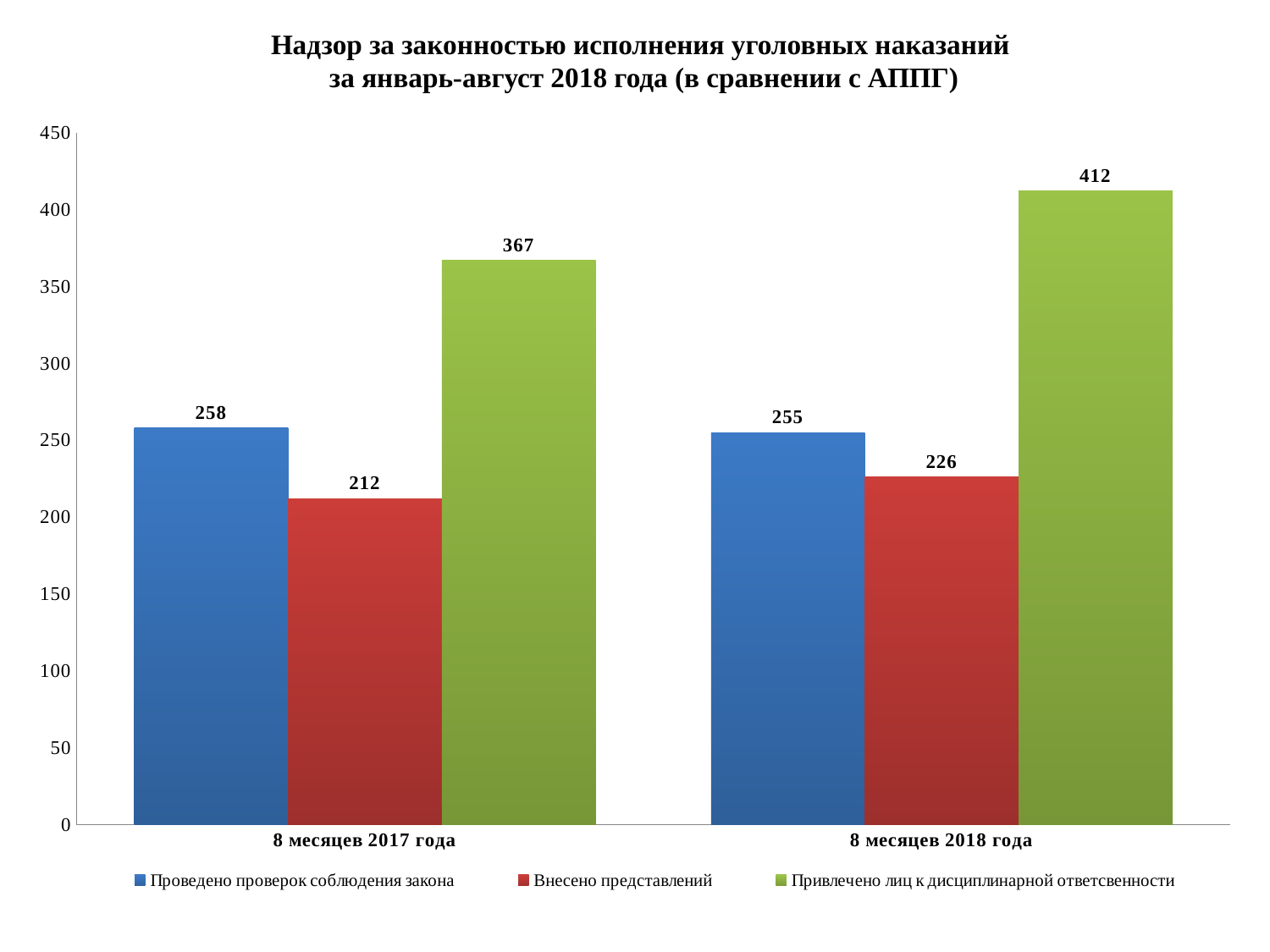
What is the value of «Внесено представлений» for «8 месяцев 2018 года»? 226 What is the value of «Проведено проверок соблюдения закона» for «8 месяцев 2017 года»? 258 How many series does the legend list? 3 What is the difference between the «Внесено представлений» values for «8 месяцев 2018 года» and «8 месяцев 2017 года»? 14 Which is larger: «Проведено проверок соблюдения закона» for «8 месяцев 2017 года» or for «8 месяцев 2018 года»? 8 месяцев 2017 года What is the value of «Привлечено лиц к дисциплинарной ответсвенности» for «8 месяцев 2017 года»? 367 What kind of chart is shown on the slide? Bar chart Which series has the highest value for «8 месяцев 2018 года»? Привлечено лиц к дисциплинарной ответсвенности What is the difference between the «Привлечено лиц к дисциплинарной ответсвенности» values for «8 месяцев 2018 года» and «8 месяцев 2017 года»? 45 Which series has the lowest value for «8 месяцев 2017 года»? Внесено представлений What colour are the bars for «Внесено представлений»? Red How many categories are shown on the x axis? 2